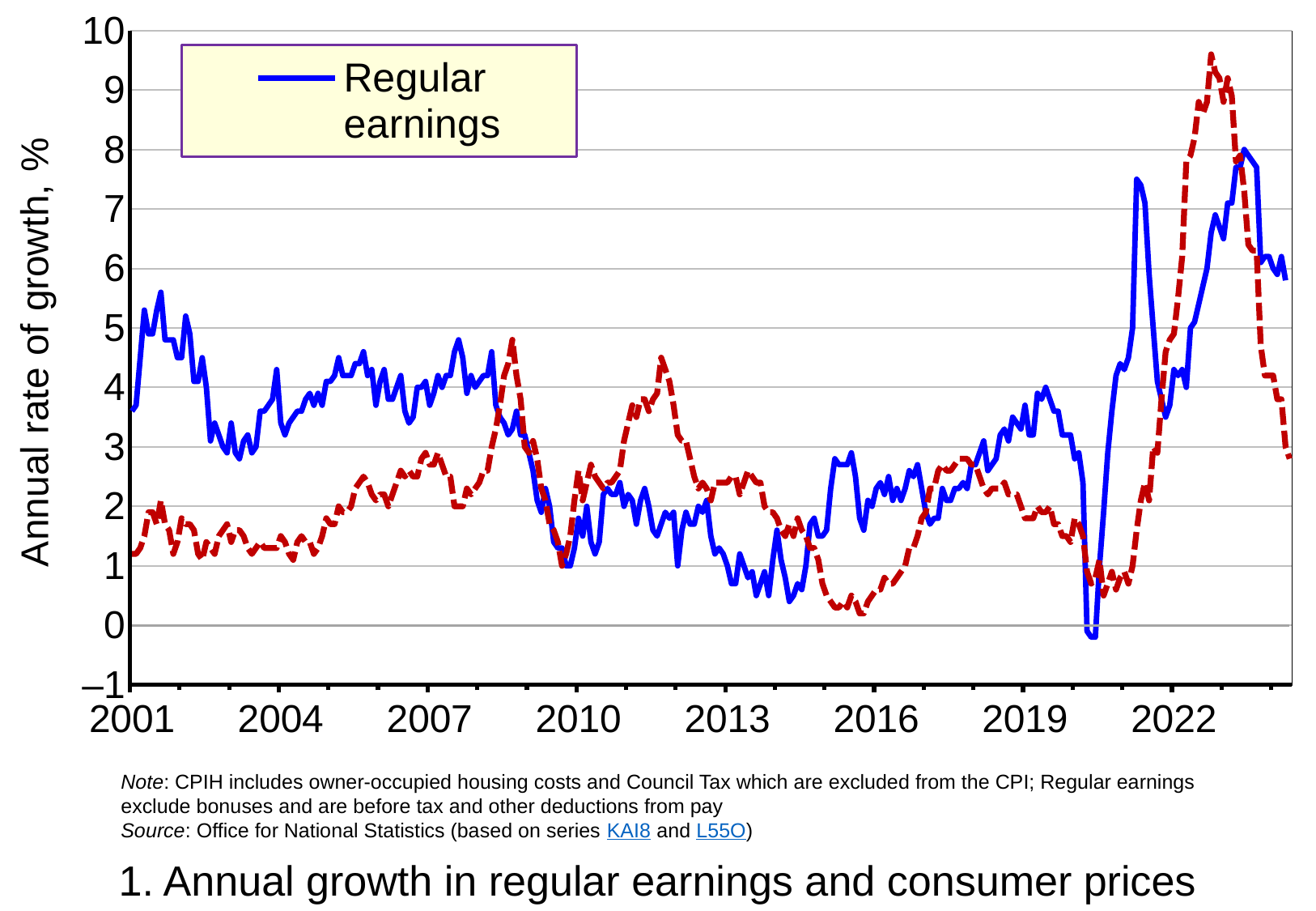
Does Regular earnings rise or fall between 2020 and 2021? Rise Which line reaches the higher peak on the chart, the blue Regular earnings line or the red dashed line? The red dashed line Does Regular earnings rise or fall between 2001 and 2003? Fall Is the value of Regular earnings around 2014 greater or less than 2? less What kind of chart is shown on the slide? Line chart Is the value of Regular earnings at the start of 2001 greater or less than 3? greater What is the title of the chart? 1. Annual growth in regular earnings and consumer prices Is the peak value of Regular earnings around 2023 greater or less than 7? greater How many series does the legend list? 1 What is the label on the y axis? Annual rate of growth, %